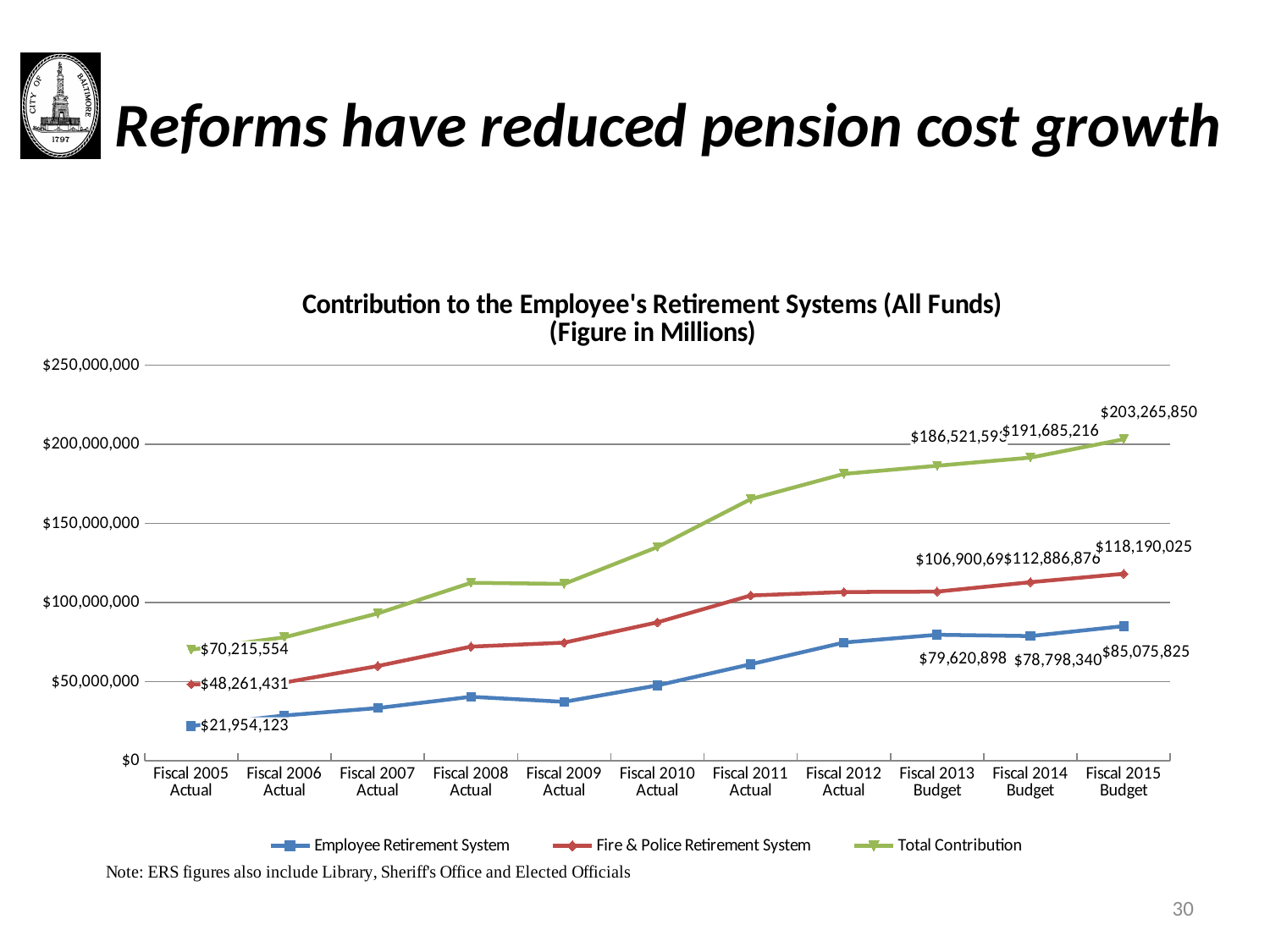
Is the Total Contribution for Fiscal 2011 Actual greater or less than $150,000,000? greater Which is larger for the Employee Retirement System: Fiscal 2013 Budget or Fiscal 2014 Budget? Fiscal 2013 Budget How many series does the legend list? 3 What is the Total Contribution for Fiscal 2015 Budget? $203,265,850 Is the Employee Retirement System value for Fiscal 2009 Actual greater or less than $50,000,000? less What is the value for the Fire & Police Retirement System in Fiscal 2014 Budget? $112,886,876 What is the Total Contribution for Fiscal 2005 Actual? $70,215,554 What is the difference between the Total Contribution in Fiscal 2015 Budget and Fiscal 2014 Budget? $11,580,634 What is the value for the Employee Retirement System in Fiscal 2005 Actual? $21,954,123 What kind of chart is shown on the slide? line chart How many fiscal years are plotted on the x axis? 11 By how much does the Employee Retirement System value increase from Fiscal 2014 Budget to Fiscal 2015 Budget? $6,277,485